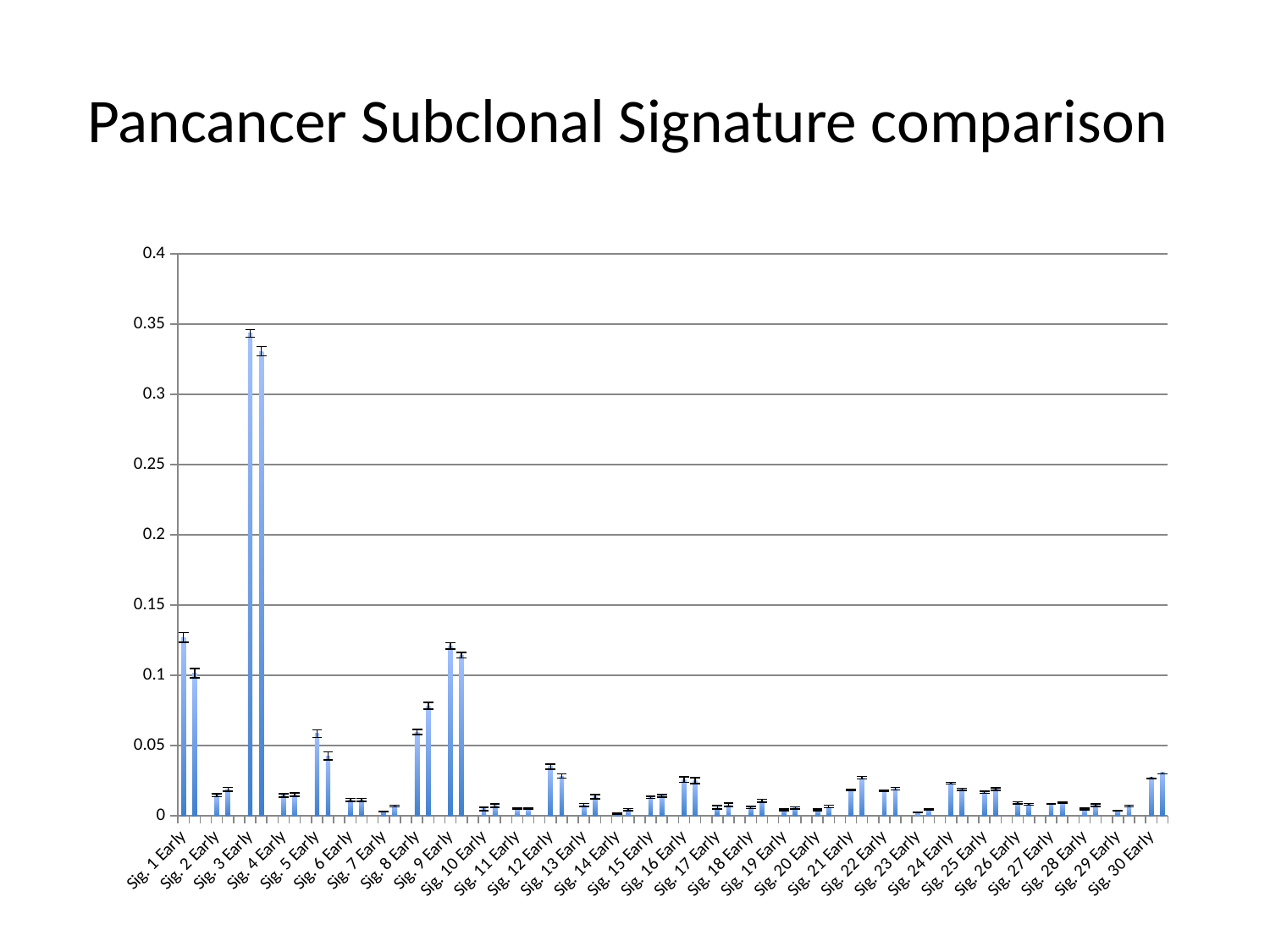
How many signature categories are labeled along the x axis? 30 What is the title of the slide? Pancancer Subclonal Signature comparison What kind of chart is shown on the slide? bar chart Is the value of the first bar for Sig. 5 Early greater or less than 0.1? less Which has the larger first bar, Sig. 3 Early or Sig. 9 Early? Sig. 3 Early Is the value of the first bar for Sig. 12 Early greater or less than 0.05? less What is the highest value shown on the y axis? 0.4 Which has the larger first bar, Sig. 1 Early or Sig. 5 Early? Sig. 1 Early Which signature category has the tallest bars? Sig. 3 Early Is the value of the first bar for Sig. 3 Early greater or less than 0.3? greater